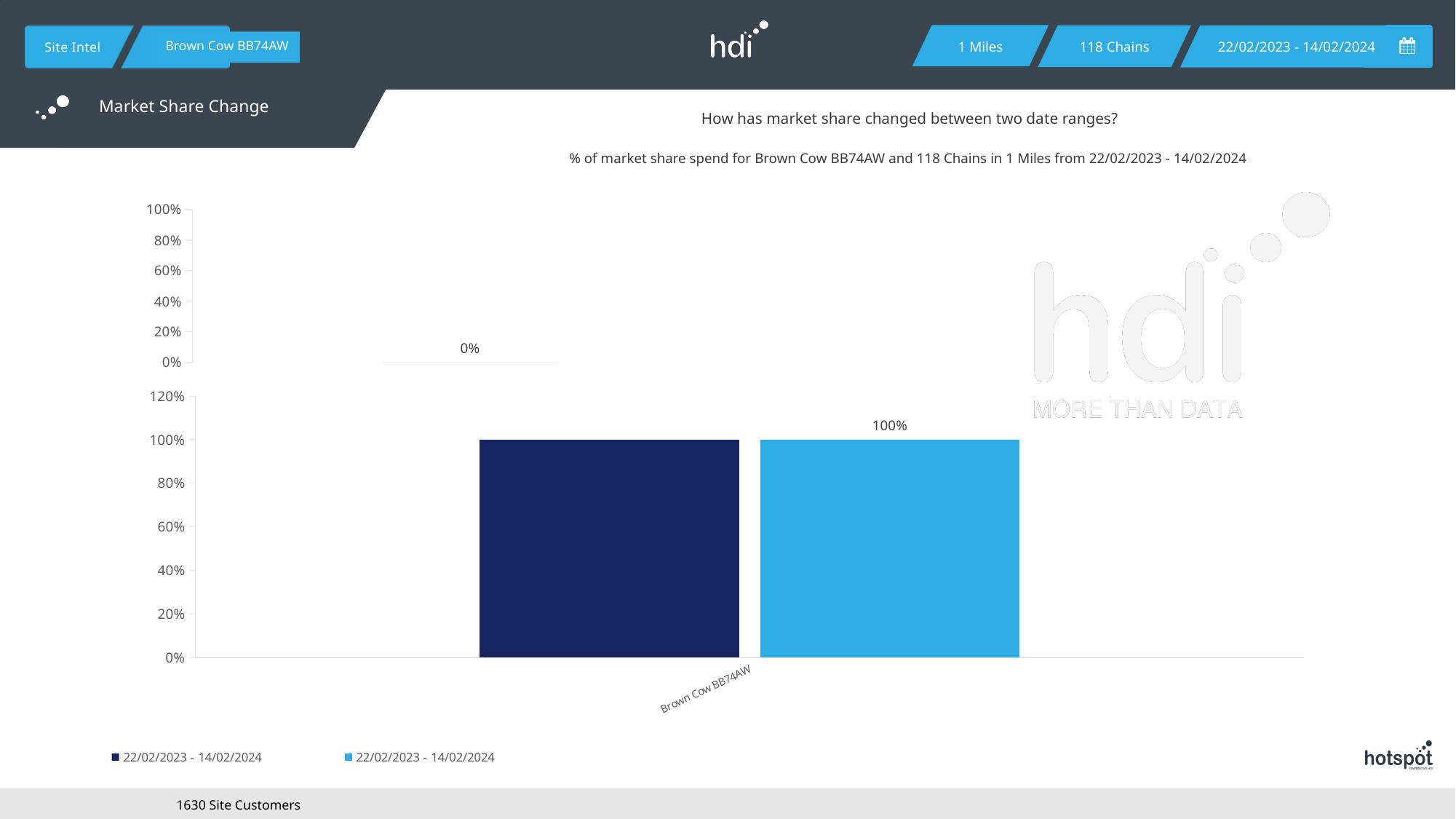
What kind of chart is the lower chart on the slide? bar chart How many series does the legend below the lower chart list? 2 What is the highest tick shown on the y axis of the lower chart? 120% What is the highest tick shown on the y axis of the upper chart? 100% In the lower chart, is the value of the dark navy bar greater or less than 80%? greater In the lower chart, what value does the dark navy bar for Brown Cow BB74AW reach on the y axis? 100% In the lower chart, are the dark navy bar and the light blue bar equal in value? yes How many categories are shown on the x axis of the lower chart? 1 What is the difference between the light blue bar and the dark navy bar in the lower chart? 0% What is the category label on the x axis of the lower chart? Brown Cow BB74AW In the upper chart, what value is printed as the data label? 0% In the lower chart, what value is printed above the light blue bar for Brown Cow BB74AW? 100%